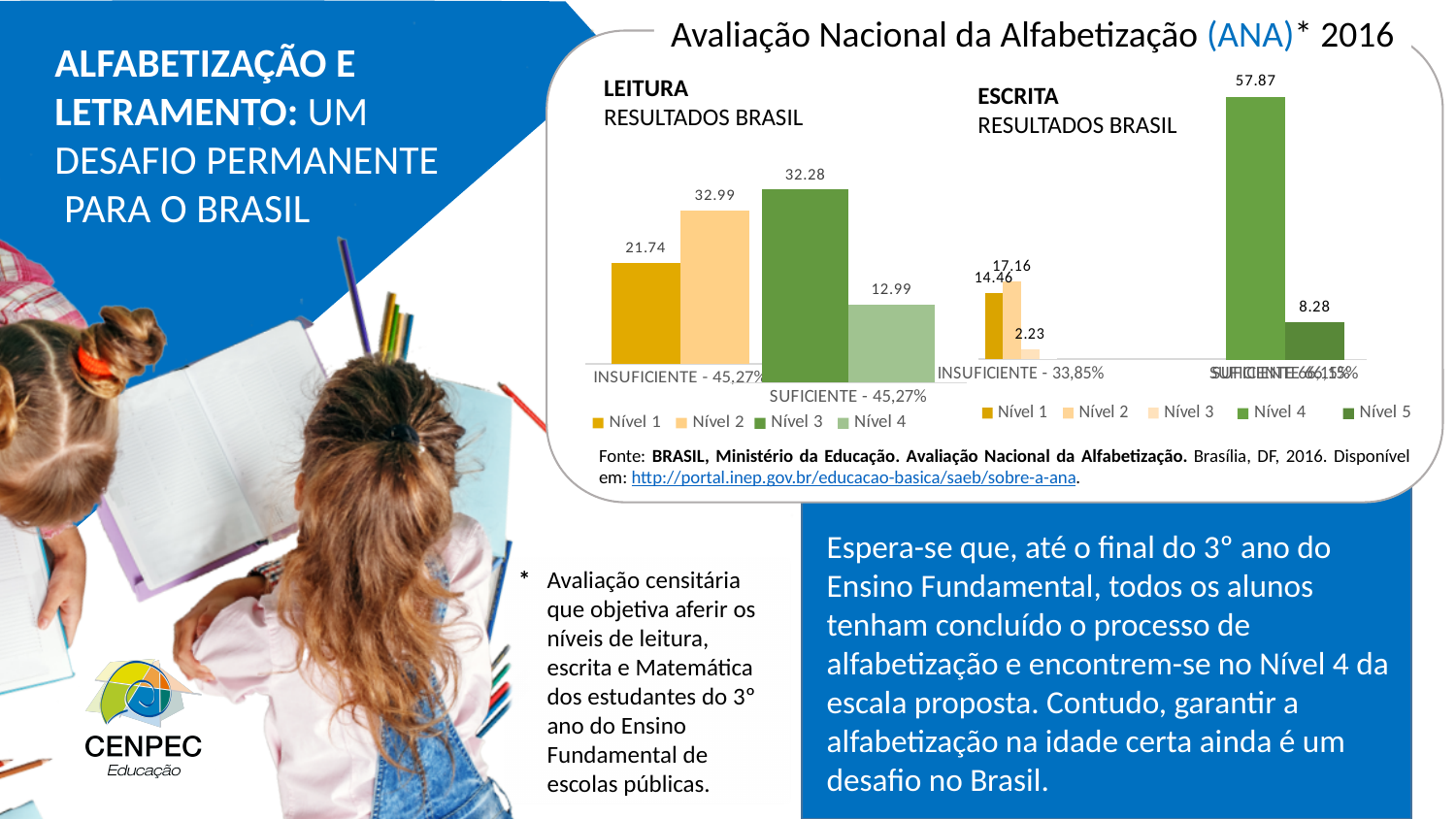
In the LEITURA RESULTADOS BRASIL chart, what is the difference between Nível 1 and Nível 4? 8.75 In the LEITURA RESULTADOS BRASIL chart, what is the value for Nível 4? 12.99 How many series does the legend of the ESCRITA RESULTADOS BRASIL chart list? 5 In the ESCRITA RESULTADOS BRASIL chart, what is the difference between Nível 4 and Nível 5? 49.59 In the ESCRITA RESULTADOS BRASIL chart, which level has the lowest value? Nível 3 In the LEITURA RESULTADOS BRASIL chart, what is the value for Nível 1? 21.74 In the ESCRITA RESULTADOS BRASIL chart, which is larger, Nível 1 or Nível 5? Nível 1 In the ESCRITA RESULTADOS BRASIL chart, what is the value for Nível 4? 57.87 In the ESCRITA RESULTADOS BRASIL chart, what is the value for Nível 3? 2.23 In the LEITURA RESULTADOS BRASIL chart, which level has the lowest value? Nível 4 What kind of chart is the LEITURA RESULTADOS BRASIL chart? Bar chart In the ESCRITA RESULTADOS BRASIL chart, which level has the highest value? Nível 4